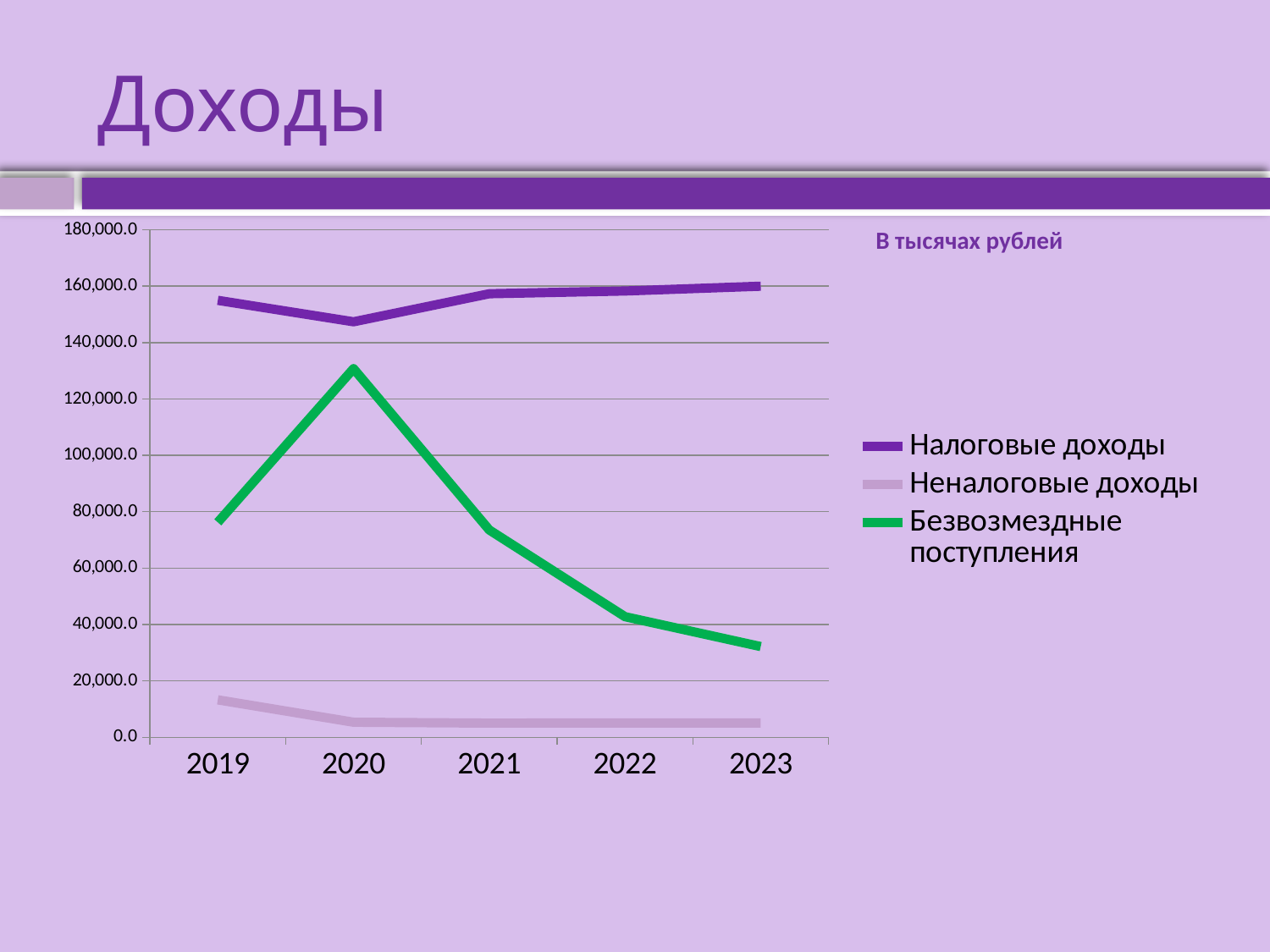
Is the value for Налоговые доходы in 2019 greater or less than 140,000.0? greater In which year is Безвозмездные поступления lowest? 2023 In which year is Безвозмездные поступления highest? 2020 What kind of chart is shown on the slide? line chart In 2019, which is larger: Налоговые доходы or Безвозмездные поступления? Налоговые доходы Is the value for Безвозмездные поступления in 2023 greater or less than 40,000.0? less In which year is Налоговые доходы lowest? 2020 Is the value for Безвозмездные поступления in 2020 greater or less than 120,000.0? greater Do the values for Безвозмездные поступления rise or fall from 2020 to 2023? fall How many years are shown on the x axis? 5 How many series does the legend list? 3 In what units are the values on the chart given, according to the note on the slide? В тысячах рублей